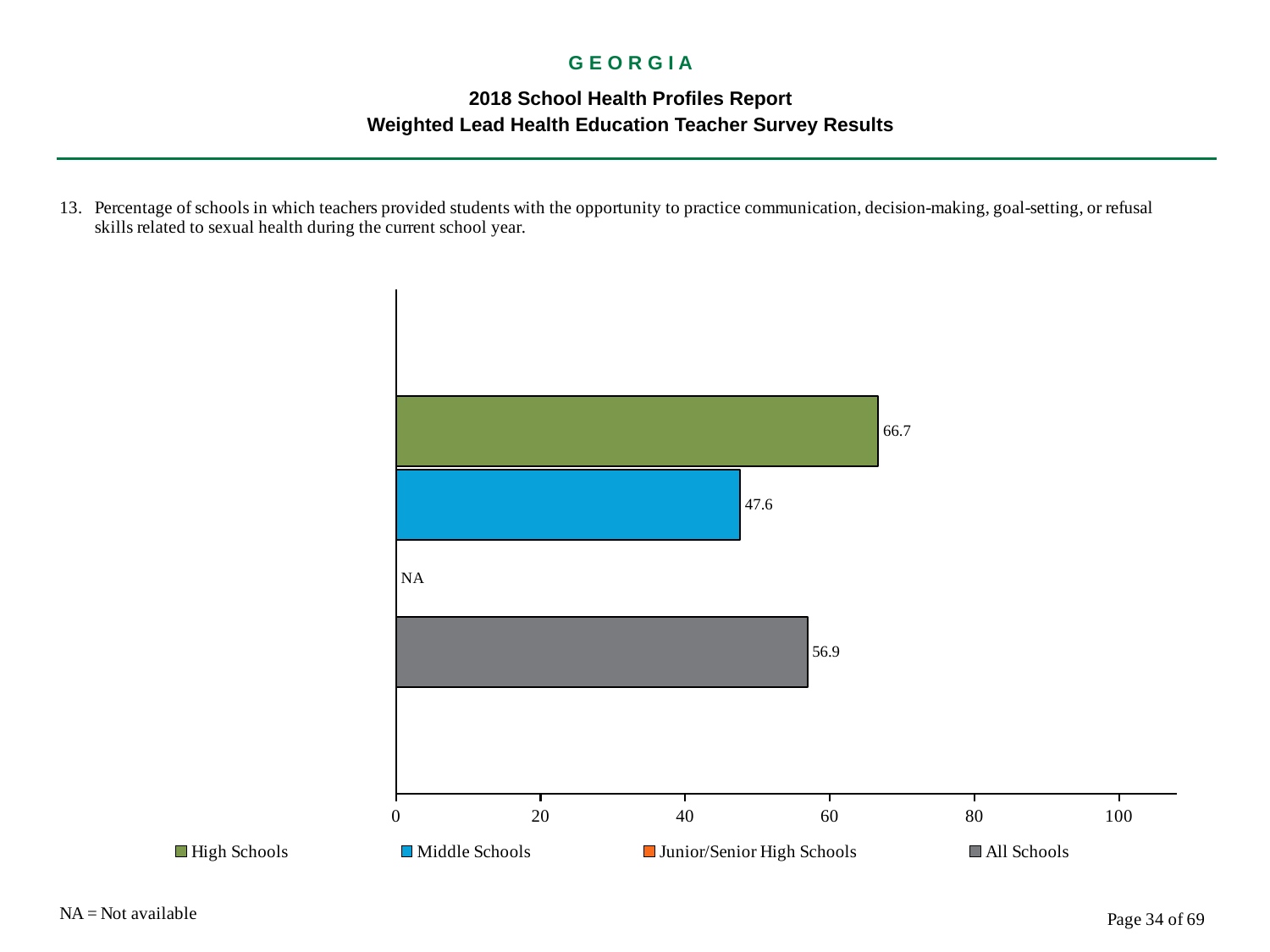
What is the value for Middle Schools? 47.6 Which is larger, the value for Middle Schools or the value for All Schools? All Schools What is the difference between the High Schools and Middle Schools values? 19.1 What is shown for Junior/Senior High Schools? NA How many series does the legend list? 4 Which school type with a plotted value has the lowest value? Middle Schools What is the difference between the High Schools and All Schools values? 9.8 What kind of chart is shown? bar chart Which school type has the highest value? High Schools What is the value for All Schools? 56.9 Is the value for Middle Schools greater or less than 60? less What is the value for High Schools? 66.7